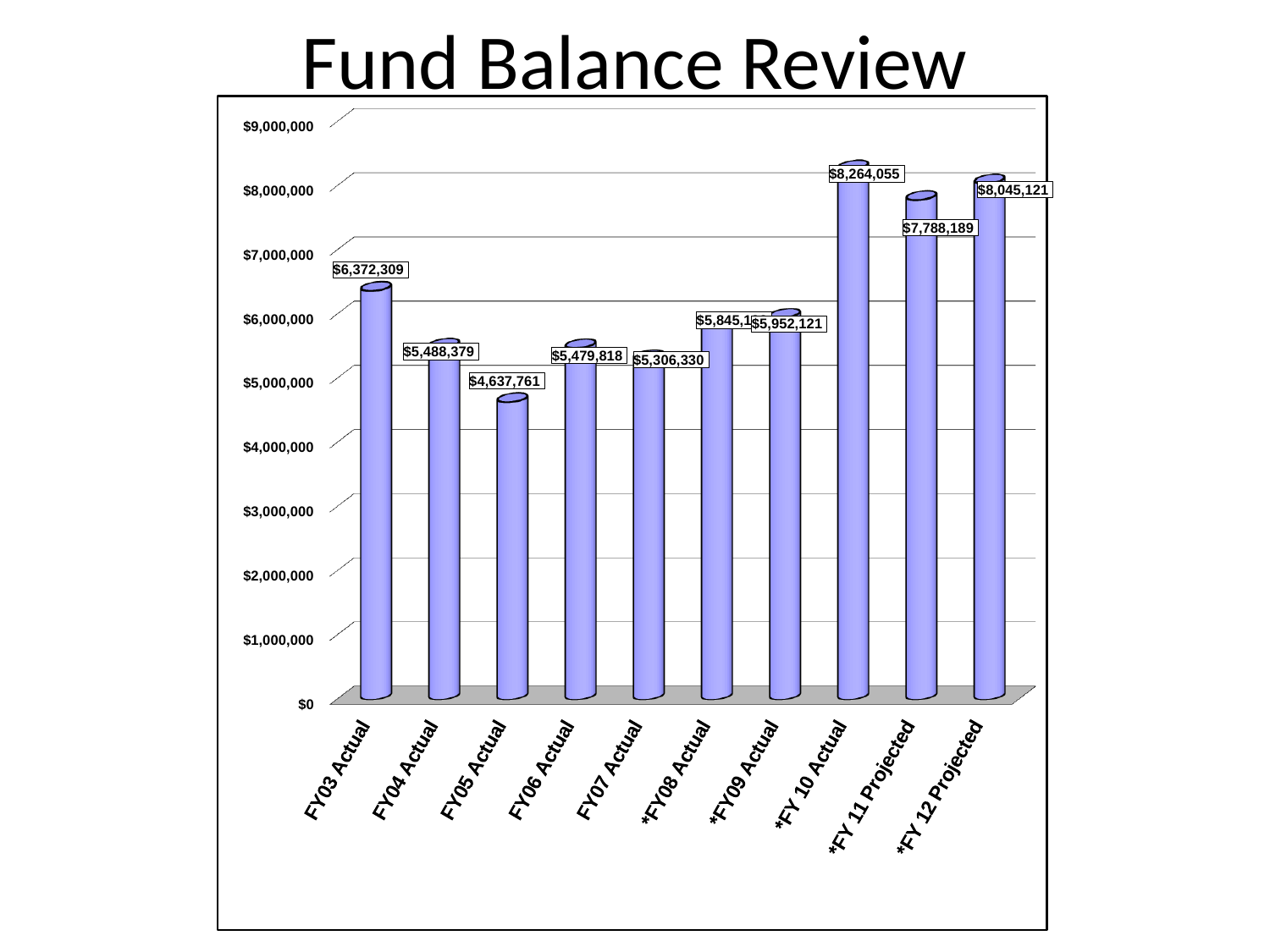
What is the value for *FY 11 Projected? $7,788,189 Which is larger, the value for *FY 12 Projected or *FY 11 Projected? *FY 12 Projected Is the value for FY07 Actual greater or less than $5,000,000? greater How many categories are shown on the x axis? 10 What is the value for FY05 Actual? $4,637,761 Which category has the lowest fund balance? FY05 Actual What is the value for *FY 12 Projected? $8,045,121 What is the difference between the values for *FY 10 Actual and *FY 11 Projected? $475,866 What kind of chart is shown on the slide? bar chart Which category has the highest fund balance? *FY 10 Actual What is the value for FY03 Actual? $6,372,309 What is the title of the slide? Fund Balance Review